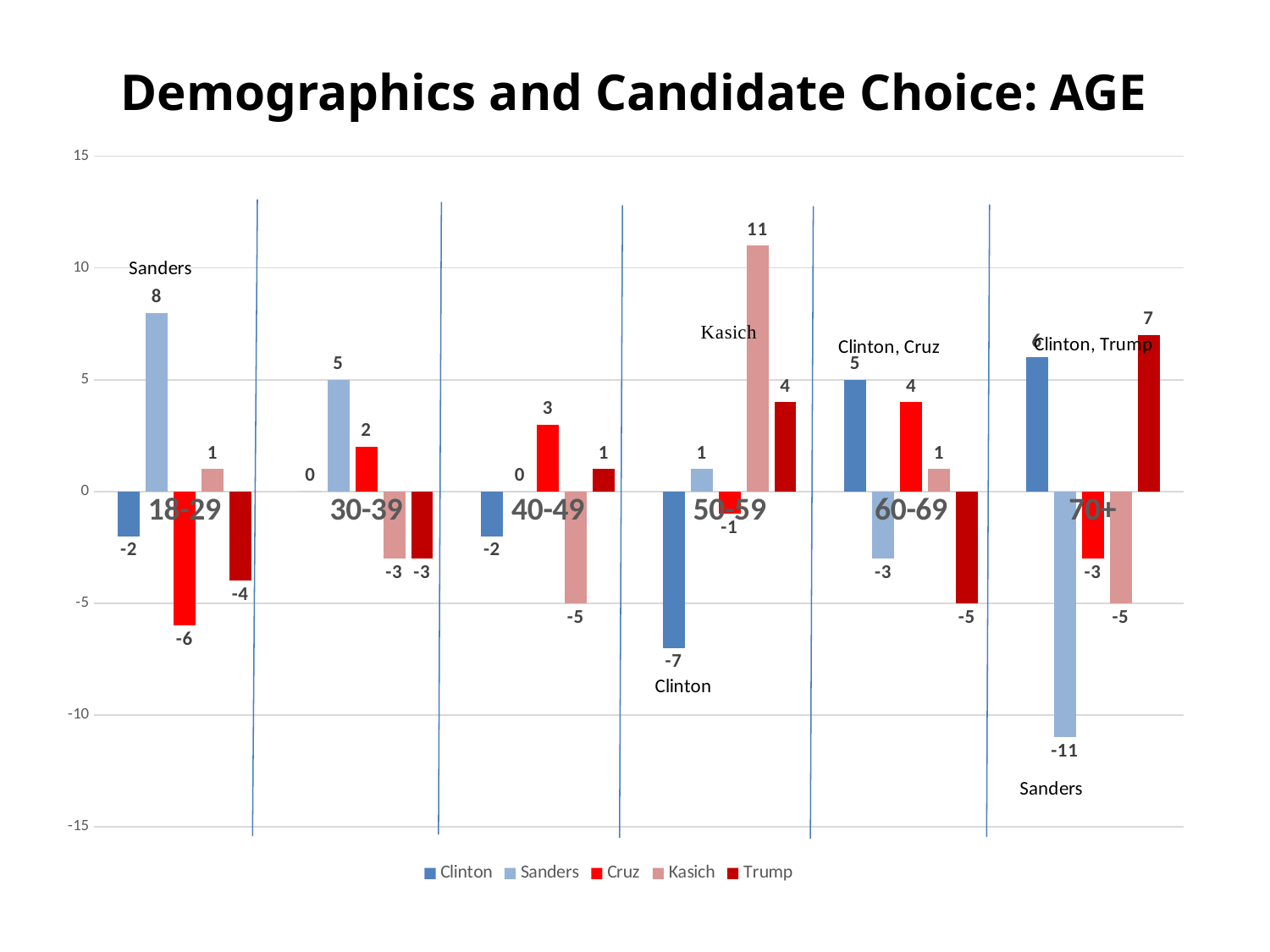
What is the value for Kasich in the 50-59 age group? 11 What is the value for Clinton in the 50-59 age group? -7 Which is larger: the Trump value for 70+ or the Clinton value for 60-69? Trump value for 70+ How many age groups are shown on the x axis? 6 How many series does the legend list? 5 What is the value for Sanders in the 18-29 age group? 8 What is the value for Trump in the 60-69 age group? -5 What kind of chart is shown on the slide? Bar chart In which age group does Sanders have the lowest value? 70+ Do the Sanders values generally rise or fall from the 18-29 group to the 70+ group? Fall What is the difference between the Sanders value and the Cruz value in the 18-29 age group? 14 In which age group does Kasich have the highest value? 50-59